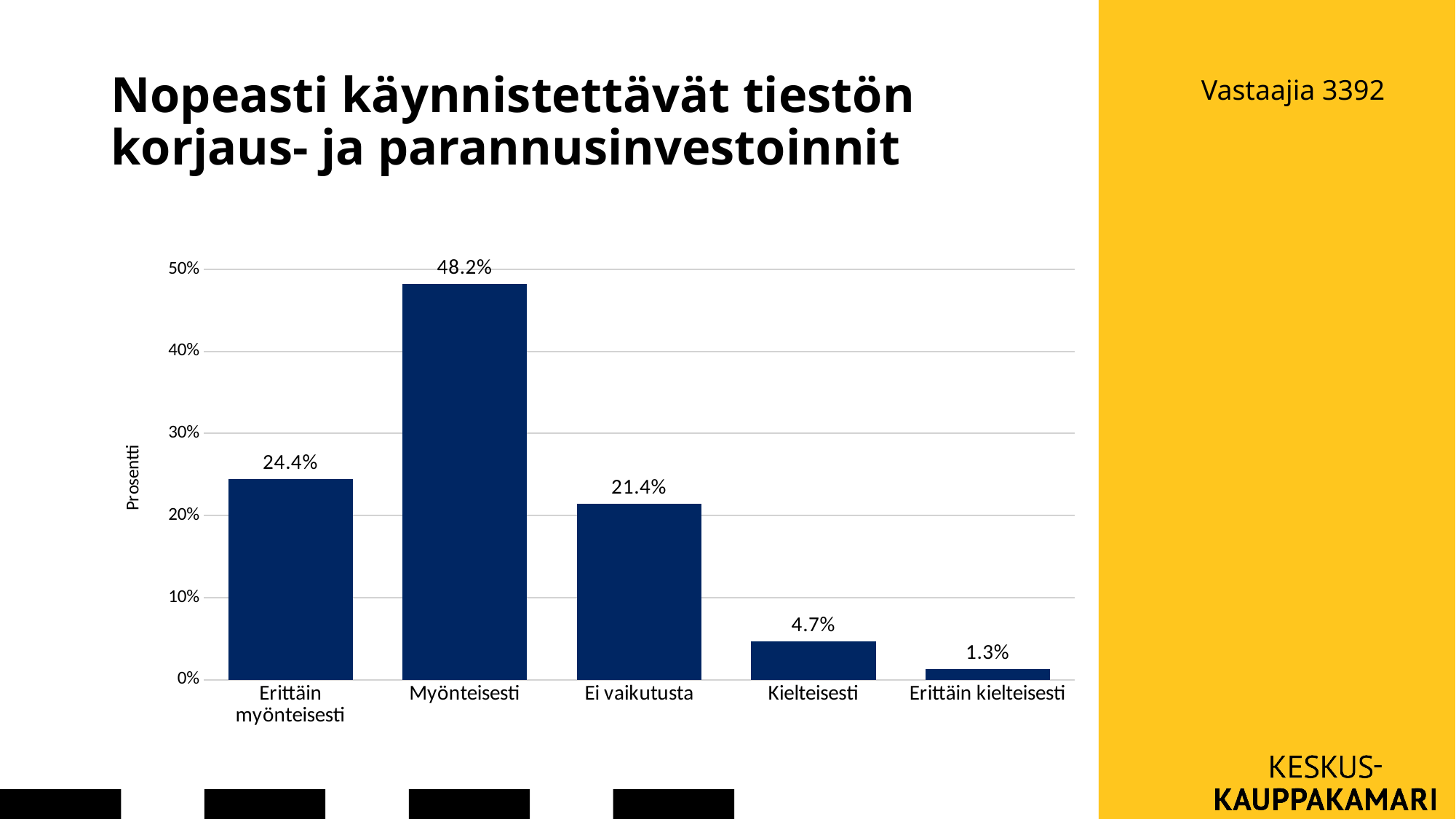
What is the value for Erittäin myönteisesti? 24.4% What is the value for Erittäin kielteisesti? 1.3% Which category has the lowest value? Erittäin kielteisesti Which is larger, the value for Erittäin myönteisesti or the value for Ei vaikutusta? Erittäin myönteisesti What kind of chart is shown on the slide? Bar chart How many categories are shown on the x axis? 5 Which category has the highest value? Myönteisesti What is the difference between the values for Myönteisesti and Erittäin myönteisesti? 23.8% What is the value for Myönteisesti? 48.2% What is the value for Kielteisesti? 4.7% What is the label of the vertical axis? Prosentti What is the value for Ei vaikutusta? 21.4%